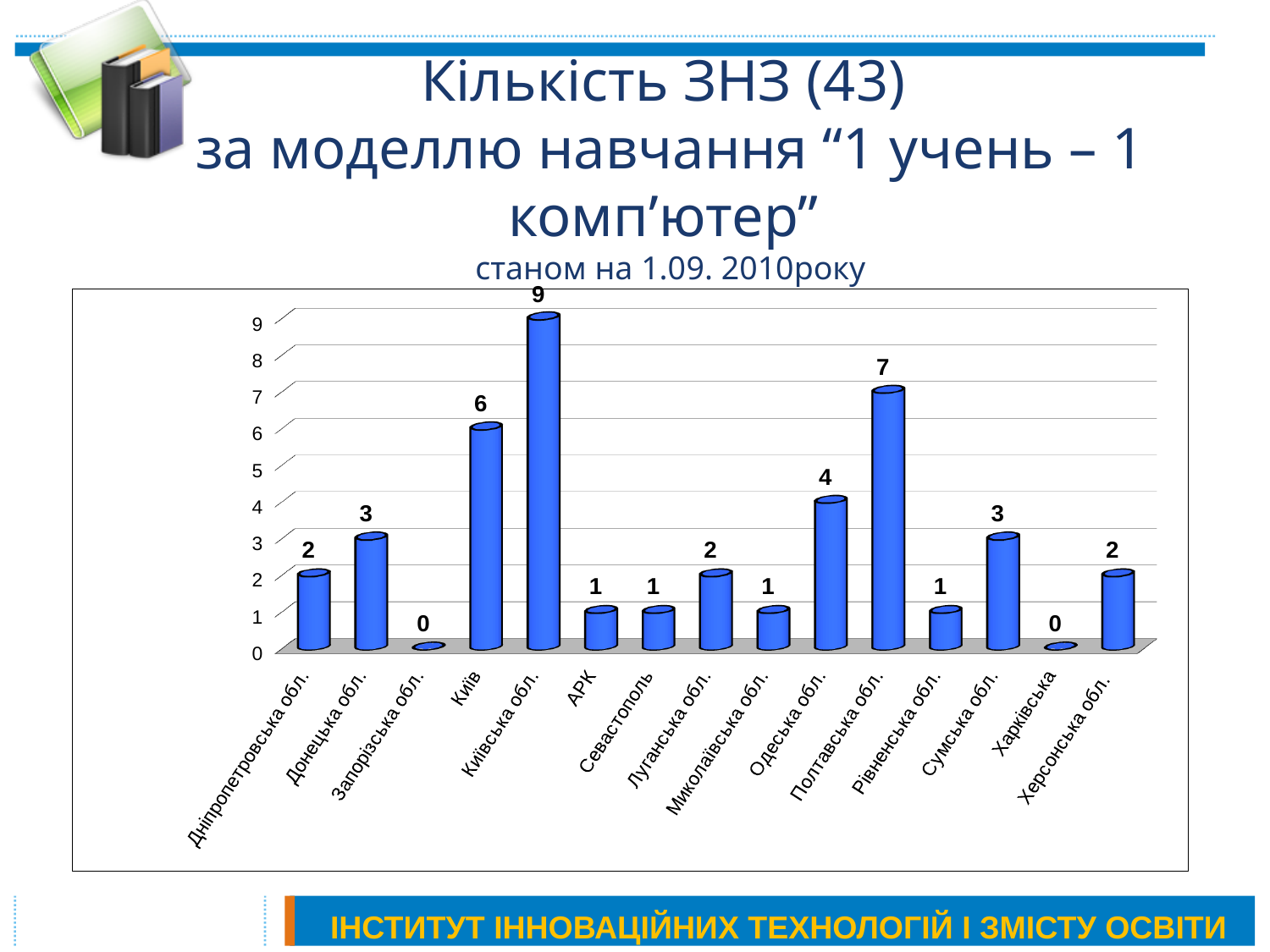
What is the difference between the values for Донецька обл. and Дніпропетровська обл.? 1 What kind of chart is shown on the slide? Bar chart Which categories have a value of 0? Запорізька обл. and Харківська Which category has the highest value? Київська обл. What date is the data stated to be current as of, according to the subtitle? 1.09. 2010 What is the value for Київська обл.? 9 How many categories are shown on the x axis? 15 What is the value for Полтавська обл.? 7 What is the difference between the values for Київська обл. and Полтавська обл.? 2 What is the value for Одеська обл.? 4 What is the value for Київ? 6 Which is larger, the value for Київ or the value for Одеська обл.? Київ